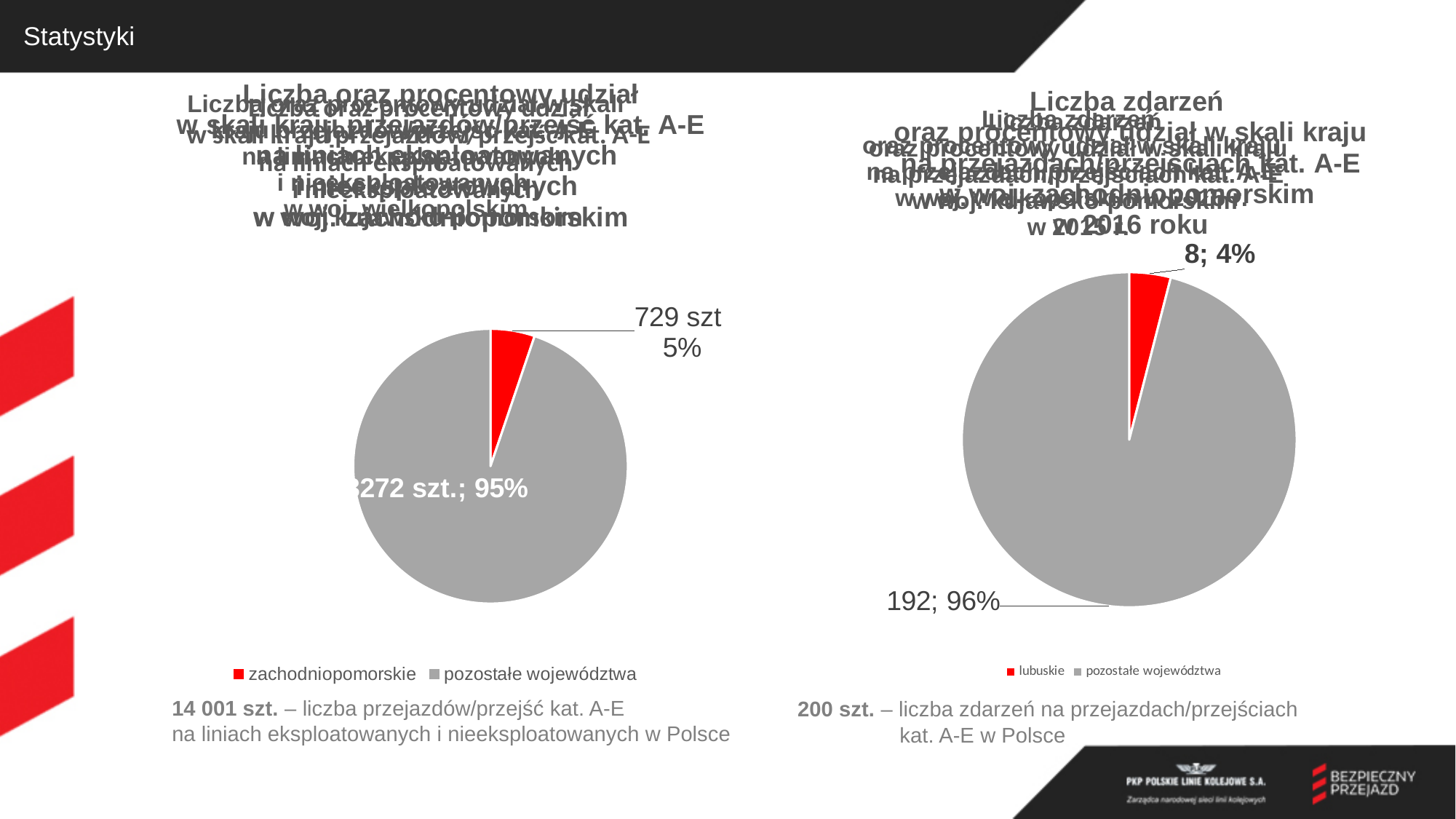
In the right pie chart, what is the difference between the value for pozostałe województwa and the value for lubuskie? 184 In the left pie chart, what value is shown for zachodniopomorskie? 729 szt In the right pie chart, what colour is the lubuskie slice? red How many slices does the right pie chart have? 2 In the right pie chart, what share of the pie does lubuskie represent? 4% How many entries does the legend of the left pie chart list? 2 In the right pie chart, what value is shown for pozostałe województwa? 192 What kind of chart is the left chart on the slide? pie chart In the left pie chart, what share of the pie does zachodniopomorskie represent? 5% In the left pie chart, which slice is larger: zachodniopomorskie or pozostałe województwa? pozostałe województwa In the left pie chart, what share of the pie does pozostałe województwa represent? 95% In the right pie chart, what value is shown for lubuskie? 8